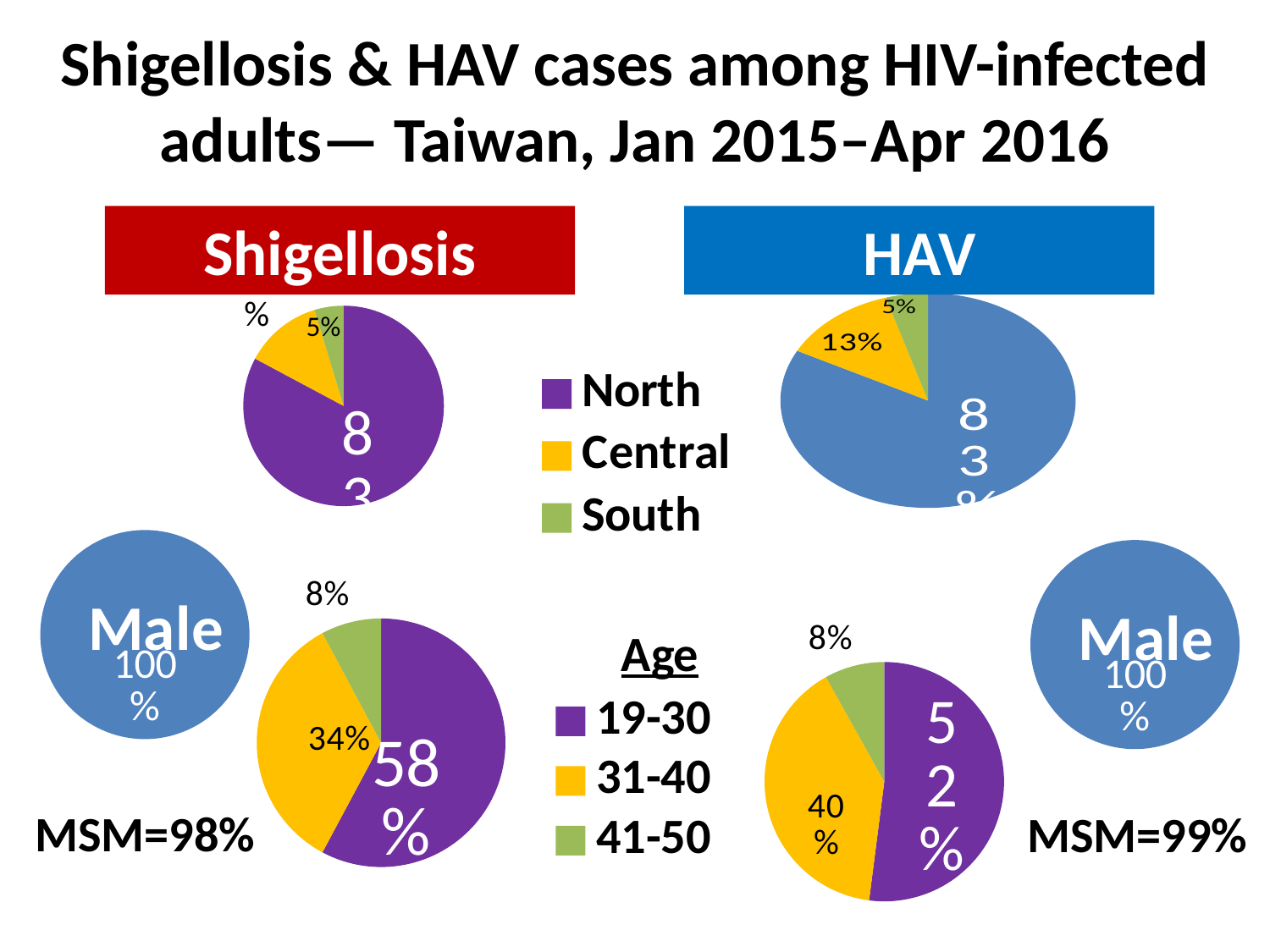
In the HAV age pie chart (bottom right), which age group has the largest share? 19-30 In the HAV region pie chart (top right), what share of cases is from the South? 5% Which is larger: the 19-30 share in the Shigellosis age pie chart or the 19-30 share in the HAV age pie chart? Shigellosis age pie chart In the Shigellosis age pie chart (bottom left), what share of cases is in the 19-30 age group? 58% In the HAV age pie chart (bottom right), what share of cases is in the 31-40 age group? 40% In the Shigellosis age pie chart (bottom left), which age group has the smallest share? 41-50 What type of chart is used to show the age distribution of Shigellosis cases? Pie chart In the HAV age pie chart (bottom right), what is the difference between the 19-30 share and the 31-40 share? 12% In the Shigellosis region pie chart (top left), what share of cases is from the South? 5% In the HAV region pie chart (top right), what share of cases is from the North? 83% In the Shigellosis age pie chart (bottom left), what share of cases is in the 31-40 age group? 34% In the HAV region pie chart (top right), what share of cases is from Central? 13%